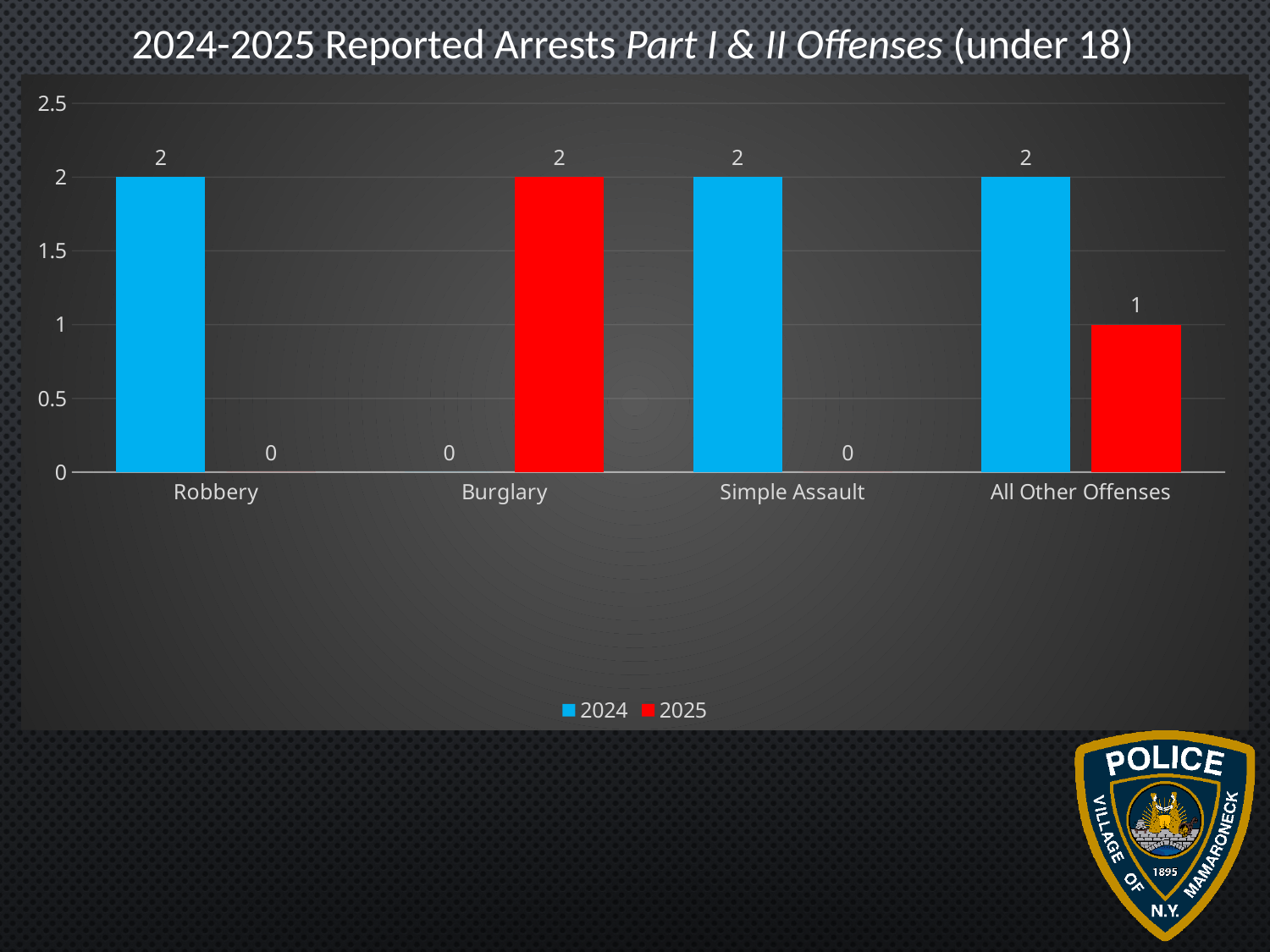
What kind of chart is shown on the slide? Bar chart What is the 2024 value for Robbery? 2 Which is larger for Burglary, the 2024 value or the 2025 value? 2025 How many offense categories are shown on the x axis? 4 What is the 2024 value for Burglary? 0 Which is larger for Robbery, the 2024 value or the 2025 value? 2024 What is the 2025 value for Burglary? 2 Which colour represents the 2025 series? Red What is the difference between the 2024 and 2025 values for All Other Offenses? 1 How many series does the legend list? 2 What is the 2025 value for Simple Assault? 0 What is the 2025 value for All Other Offenses? 1